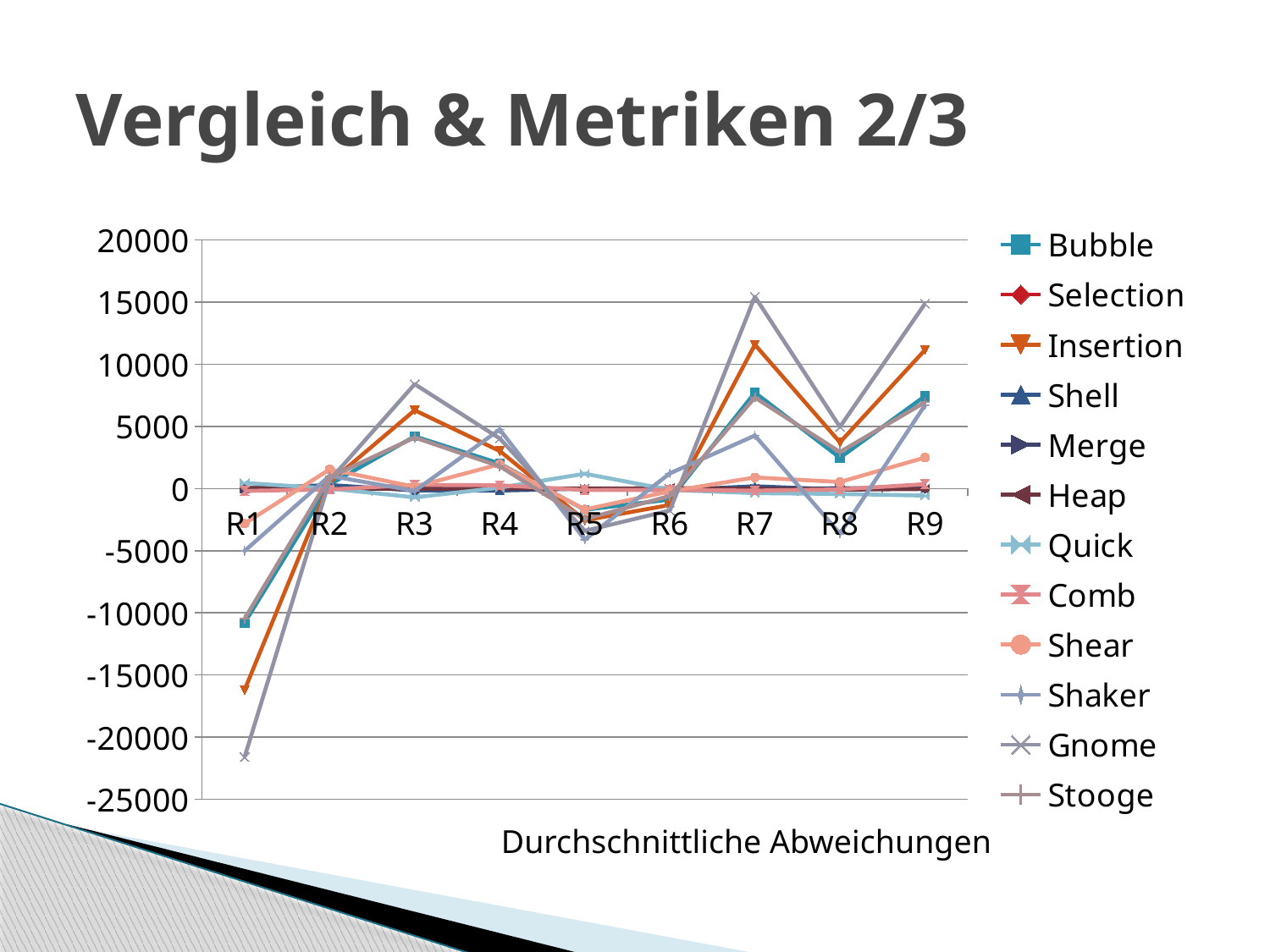
Is the value for Gnome at R1 greater or less than -20000? less At R7, which is larger: the value for Gnome or the value for Insertion? Gnome Which series has the lowest value at R1? Gnome Is the value for Gnome at R3 greater or less than 5000? greater How many series does the chart's legend list? 12 Which series has the highest value at R7? Gnome Is the value for Insertion at R7 greater or less than 10000? greater What text is shown directly below the chart's x axis? Durchschnittliche Abweichungen How many categories are shown on the x axis of the chart? 9 What kind of chart is shown on the slide? line chart